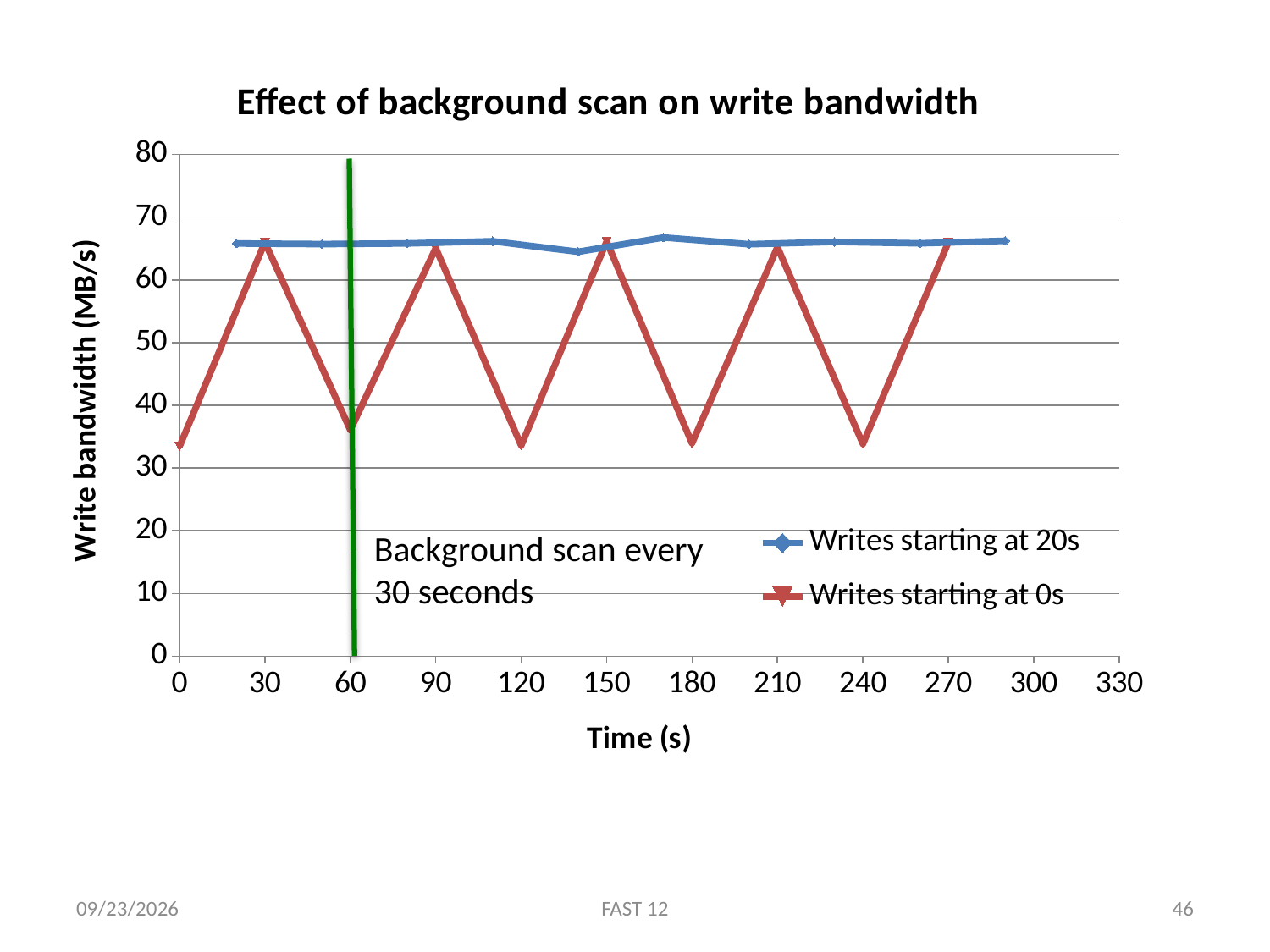
For "Writes starting at 0s", is the value at 30 s larger or smaller than the value at 60 s? larger How many series does the legend list? 2 What kind of chart is shown on the slide? line chart What is the title of the chart? Effect of background scan on write bandwidth Does the "Writes starting at 0s" series rise or fall between 30 s and 60 s? fall Is the value for "Writes starting at 0s" at 90 s greater or less than 60? greater Is the value for "Writes starting at 0s" at 120 s greater or less than 40? less What is the label of the vertical axis? Write bandwidth (MB/s) Is the value for "Writes starting at 20s" at 170 s greater or less than 60? greater At 180 s, which series has the higher write bandwidth, "Writes starting at 20s" or "Writes starting at 0s"? Writes starting at 20s Does the "Writes starting at 0s" series rise or fall between 0 s and 30 s? rise